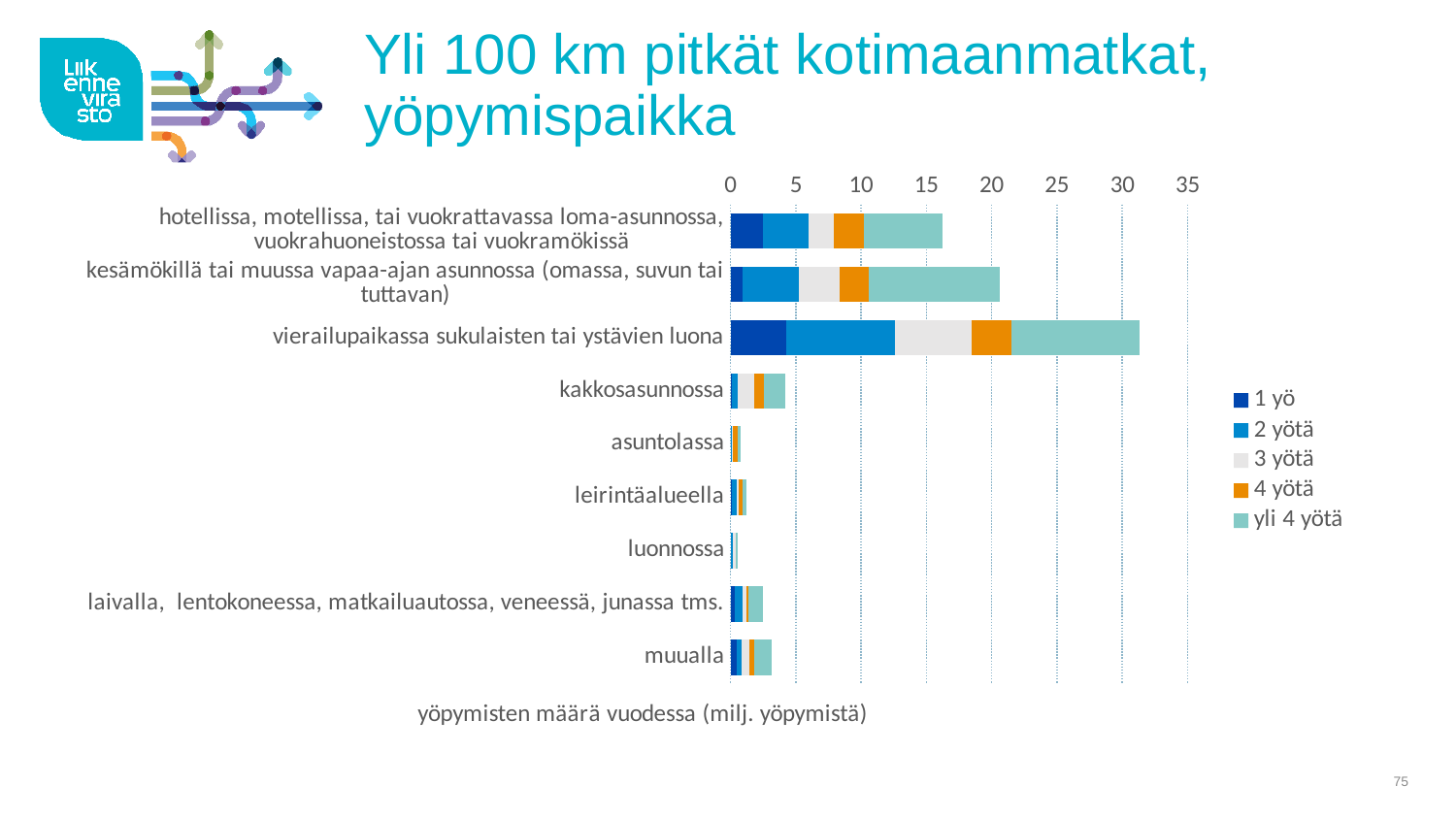
Which has a larger total: 'kesämökillä tai muussa vapaa-ajan asunnossa' or 'hotellissa, motellissa, tai vuokrattavassa loma-asunnossa'? kesämökillä tai muussa vapaa-ajan asunnossa What is the title of the slide? Yli 100 km pitkät kotimaanmatkat, yöpymispaikka What kind of chart is shown on the slide? stacked bar chart How many series does the legend list? 5 What is the label of the horizontal axis? yöpymisten määrä vuodessa (milj. yöpymistä) Which category has the highest total number of overnight stays? vierailupaikassa sukulaisten tai ystävien luona Is the total value for 'vierailupaikassa sukulaisten tai ystävien luona' greater or less than 30? greater Is the total value for 'kakkosasunnossa' greater or less than 5? less Which has a larger total: 'vierailupaikassa sukulaisten tai ystävien luona' or 'kesämökillä tai muussa vapaa-ajan asunnossa'? vierailupaikassa sukulaisten tai ystävien luona Is the total value for 'hotellissa, motellissa, tai vuokrattavassa loma-asunnossa, vuokrahuoneistossa tai vuokramökissä' greater or less than 15? greater How many accommodation categories are plotted on the chart? 9 Which category has the lowest total number of overnight stays? luonnossa